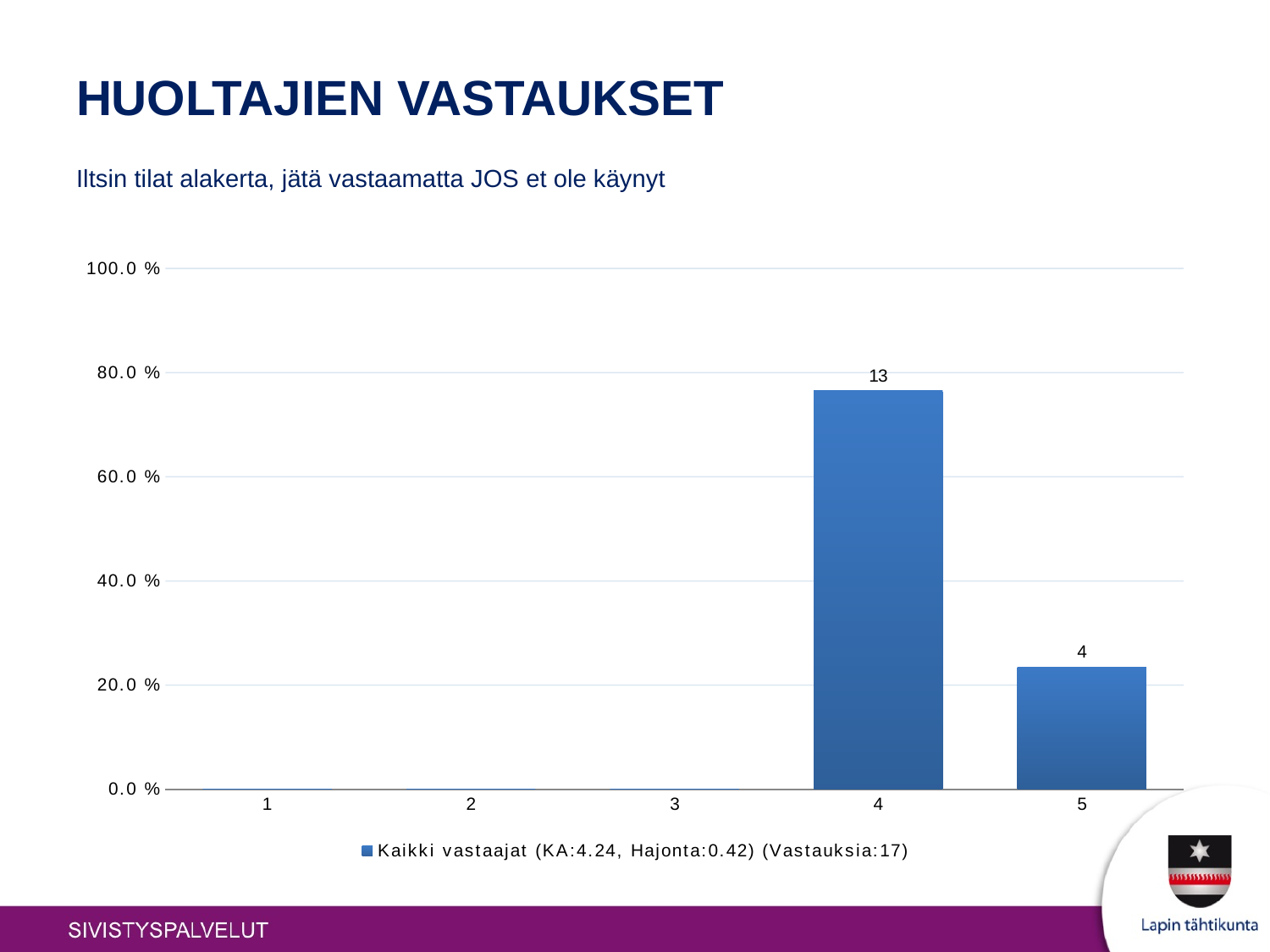
Which category has the highest bar? 4 Is the bar for category 5 greater or less than 40.0 %? less What data label is shown on the bar for category 4? 13 How many categories are shown on the x axis? 5 What data label is shown on the bar for category 5? 4 Is the bar for category 4 greater or less than 60.0 %? greater How many series does the legend list? 1 What is the difference between the data labels for category 4 and category 5? 9 What is the mean (KA) value given in the legend entry? 4.24 According to the legend, how many responses (Vastauksia) does the series include? 17 What kind of chart is shown on the slide? bar chart Which bar is taller, category 4 or category 5? 4